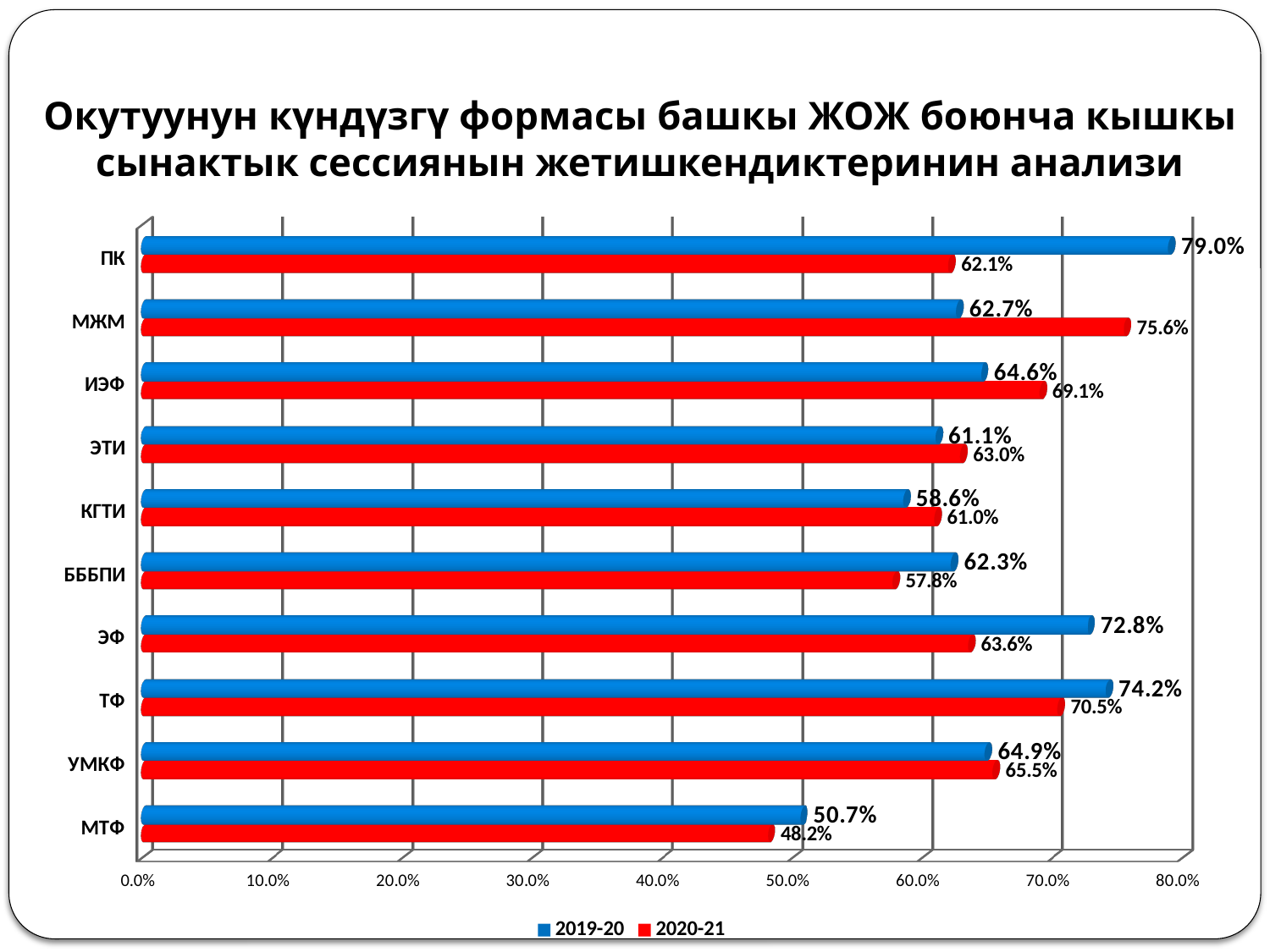
What is the 2020-21 value for МЖМ? 75.6% Is the 2020-21 value for ТФ greater or less than 60.0%? greater Which colour represents the 2020-21 series? Red What kind of chart is shown on the slide? Bar chart What is the 2019-20 value for ПК? 79.0% What is the difference between the 2019-20 and 2020-21 values for ПК? 16.9% Which is larger for ЭФ, the 2019-20 value or the 2020-21 value? 2019-20 Which category has the lowest 2020-21 value? МТФ Which category has the highest 2019-20 value? ПК How many series does the legend list? 2 How many categories are shown on the chart? 10 What is the 2020-21 value for МТФ? 48.2%